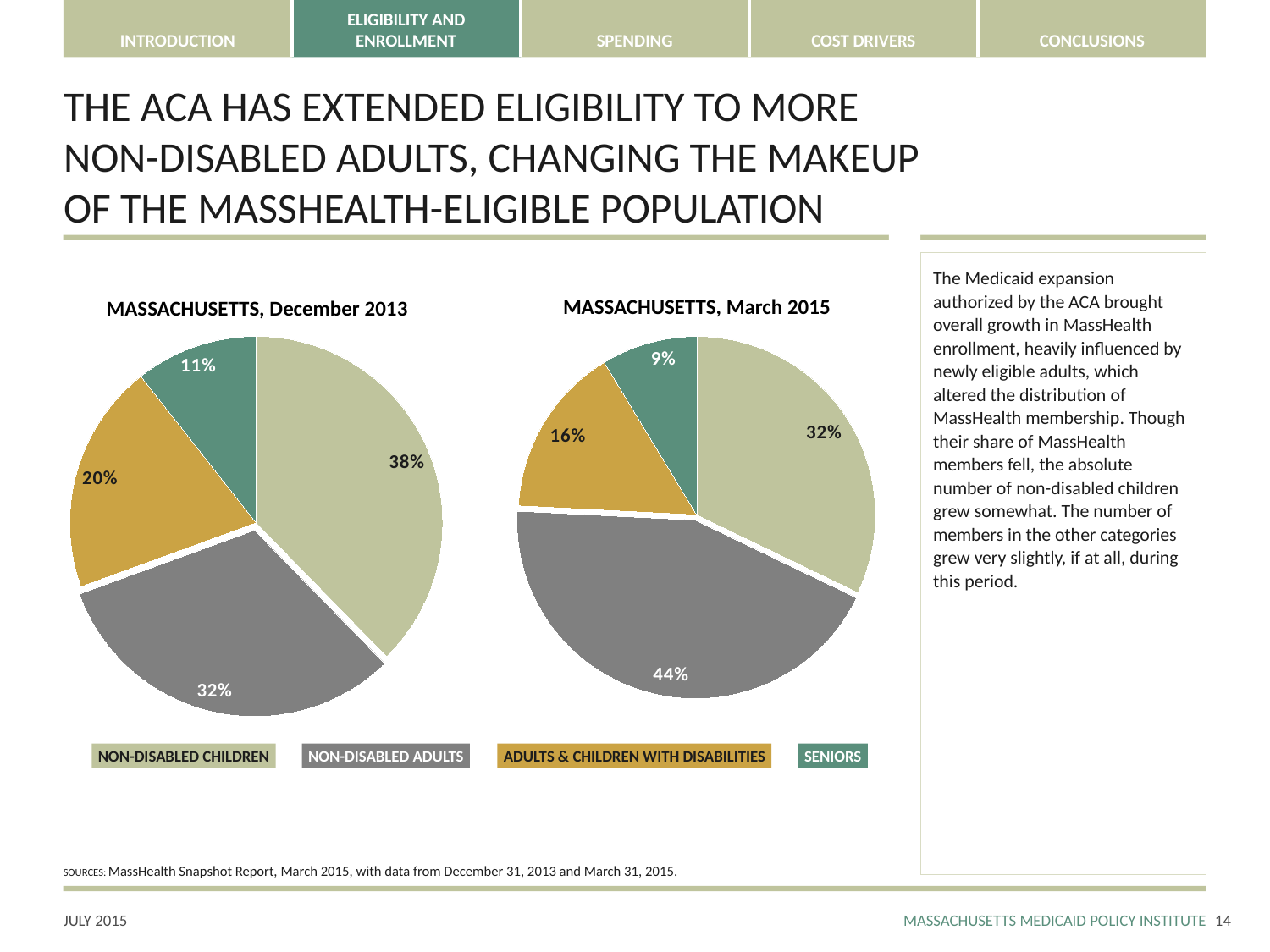
In the MASSACHUSETTS, March 2015 chart, which category has the smallest share? SENIORS In the MASSACHUSETTS, December 2013 chart, what share of the pie is NON-DISABLED CHILDREN? 38% In the MASSACHUSETTS, March 2015 chart, which category has the largest share? NON-DISABLED ADULTS Which category does the dark green colour represent in the legend? SENIORS In the MASSACHUSETTS, December 2013 chart, which category has the largest share? NON-DISABLED CHILDREN What kind of charts are shown on the slide? Pie charts In the MASSACHUSETTS, March 2015 chart, what share of the pie is NON-DISABLED ADULTS? 44% In the MASSACHUSETTS, March 2015 chart, what is the value for ADULTS & CHILDREN WITH DISABILITIES? 16% How many categories does each pie chart on the slide show? 4 In the MASSACHUSETTS, December 2013 chart, what is the value for SENIORS? 11% What is the difference between the NON-DISABLED ADULTS share in the March 2015 chart and in the December 2013 chart? 12% In the MASSACHUSETTS, December 2013 chart, which is larger: the share for NON-DISABLED ADULTS or for ADULTS & CHILDREN WITH DISABILITIES? NON-DISABLED ADULTS